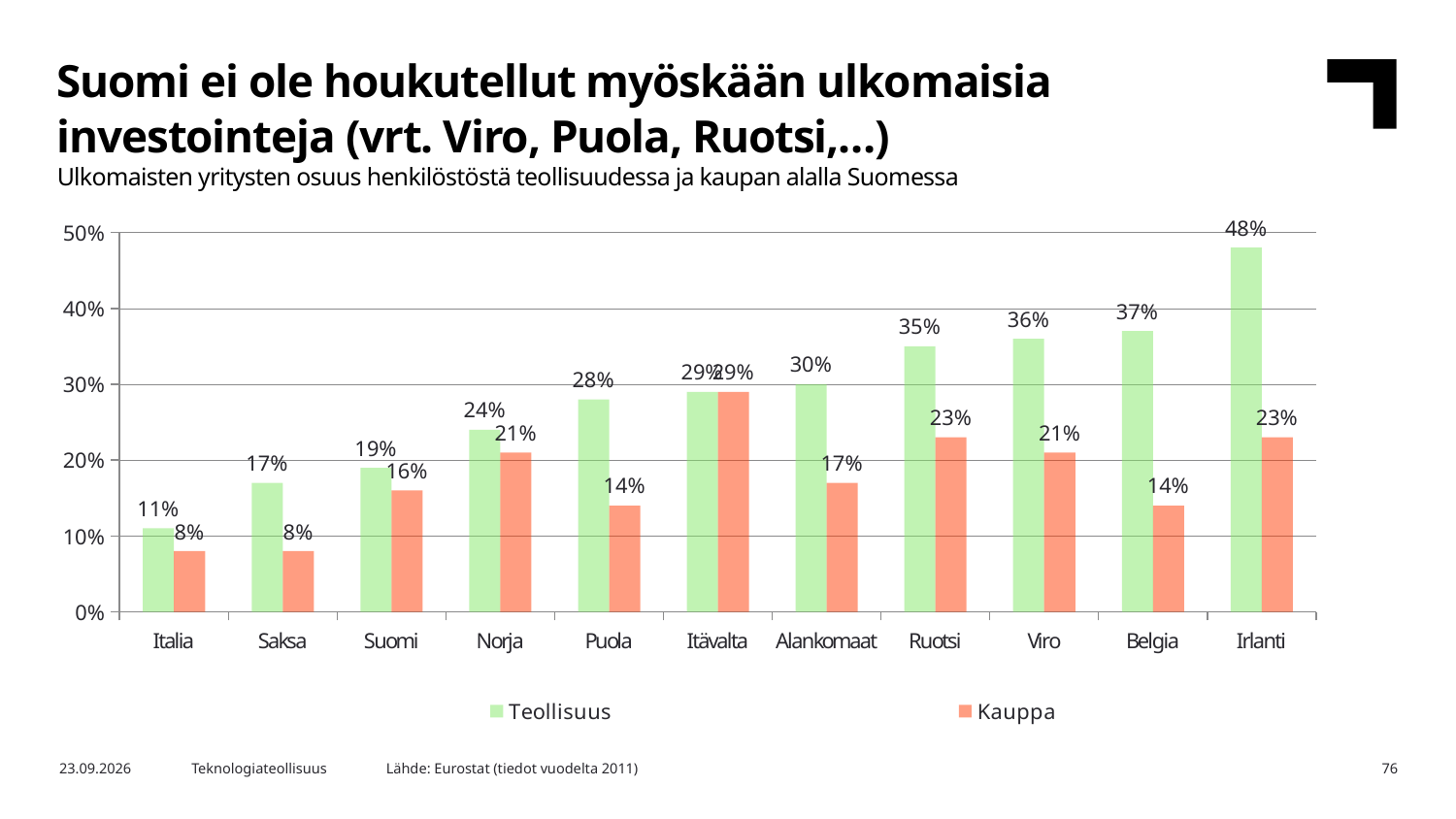
Which colour represents the Kauppa series in the legend? Orange What kind of chart is shown on the slide? Bar chart How many countries are shown on the x axis? 11 Which country has the highest Teollisuus value? Irlanti Is the Teollisuus value for Belgia greater or less than 30%? greater What is the Kauppa value for Viro? 21% What is the Teollisuus value for Suomi? 19% Which country has the lowest Teollisuus value? Italia Which is larger, the Kauppa value for Ruotsi or the Kauppa value for Alankomaat? Ruotsi Do the Teollisuus values rise or fall from Italia to Irlanti along the x axis? Rise What is the difference between the Teollisuus and Kauppa values for Puola? 14% How many series does the legend list? 2